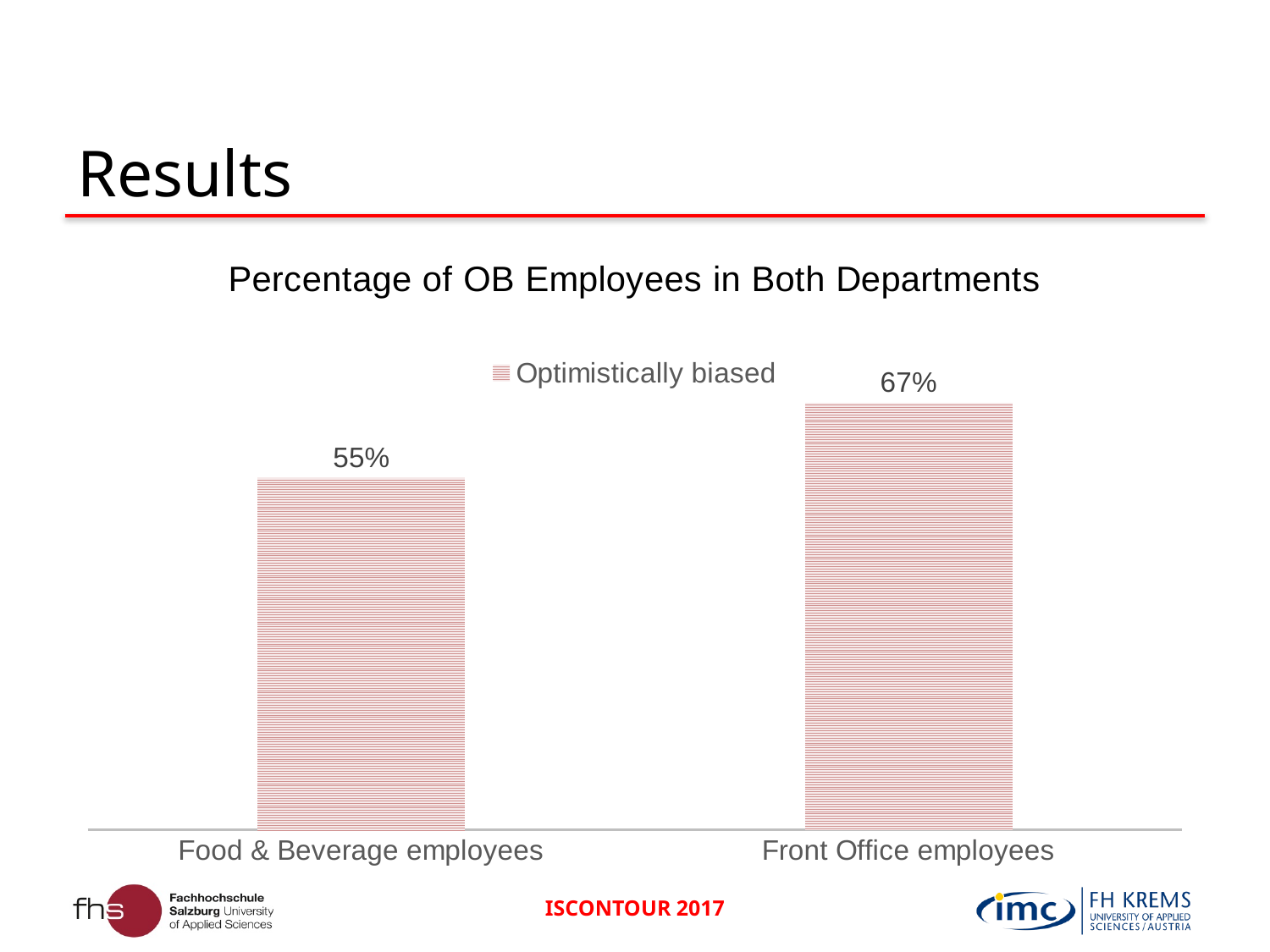
What is the value for Front Office employees? 67% How many series does the legend list? 1 Which category has the highest percentage of optimistically biased employees? Front Office employees What is the value for Food & Beverage employees? 55% Which is larger, the value for Food & Beverage employees or the value for Front Office employees? Front Office employees Which category has the lowest percentage of optimistically biased employees? Food & Beverage employees How many categories are shown on the chart? 2 What kind of chart is shown on the slide? Bar chart What is the difference between the values for Front Office employees and Food & Beverage employees? 12% What is the name of the series listed in the legend? Optimistically biased What is the title of the chart? Percentage of OB Employees in Both Departments